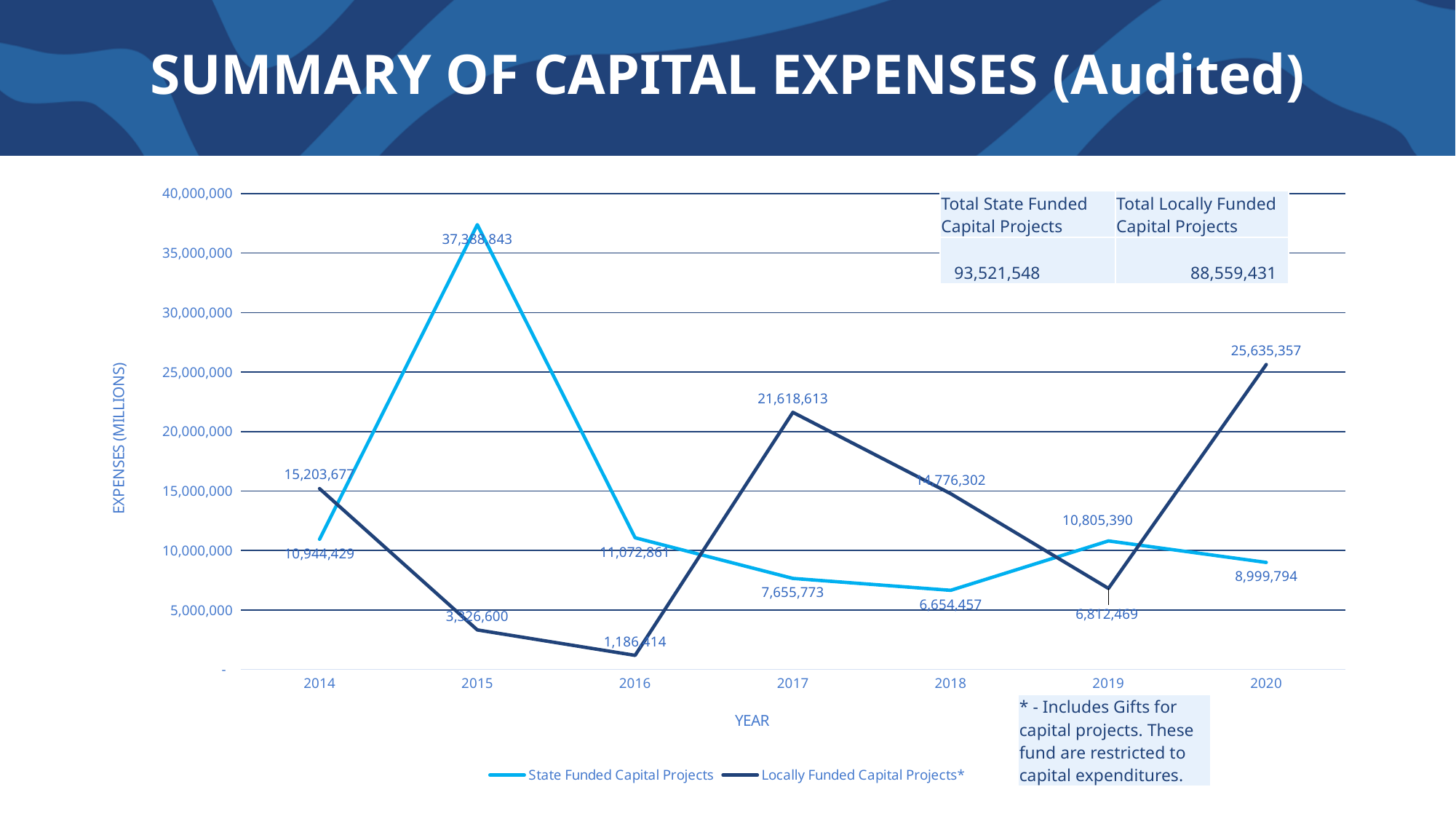
How many years are plotted along the x axis? 7 In which year is Locally Funded Capital Projects lowest? 2016 How many series does the legend list? 2 What is the value for Locally Funded Capital Projects in 2016? 1,186,414 What is the value for State Funded Capital Projects in 2015? 37,388,843 What is the difference between Locally Funded Capital Projects in 2020 and State Funded Capital Projects in 2020? 16,635,563 What is the value for Locally Funded Capital Projects in 2020? 25,635,357 What is the Total State Funded Capital Projects figure shown in the table on the chart? 93,521,548 What type of chart is shown on the slide? line chart In which year is State Funded Capital Projects highest? 2015 Which series has the larger value in 2017, State Funded or Locally Funded Capital Projects? Locally Funded Capital Projects Does State Funded Capital Projects rise or fall from 2015 to 2016? fall